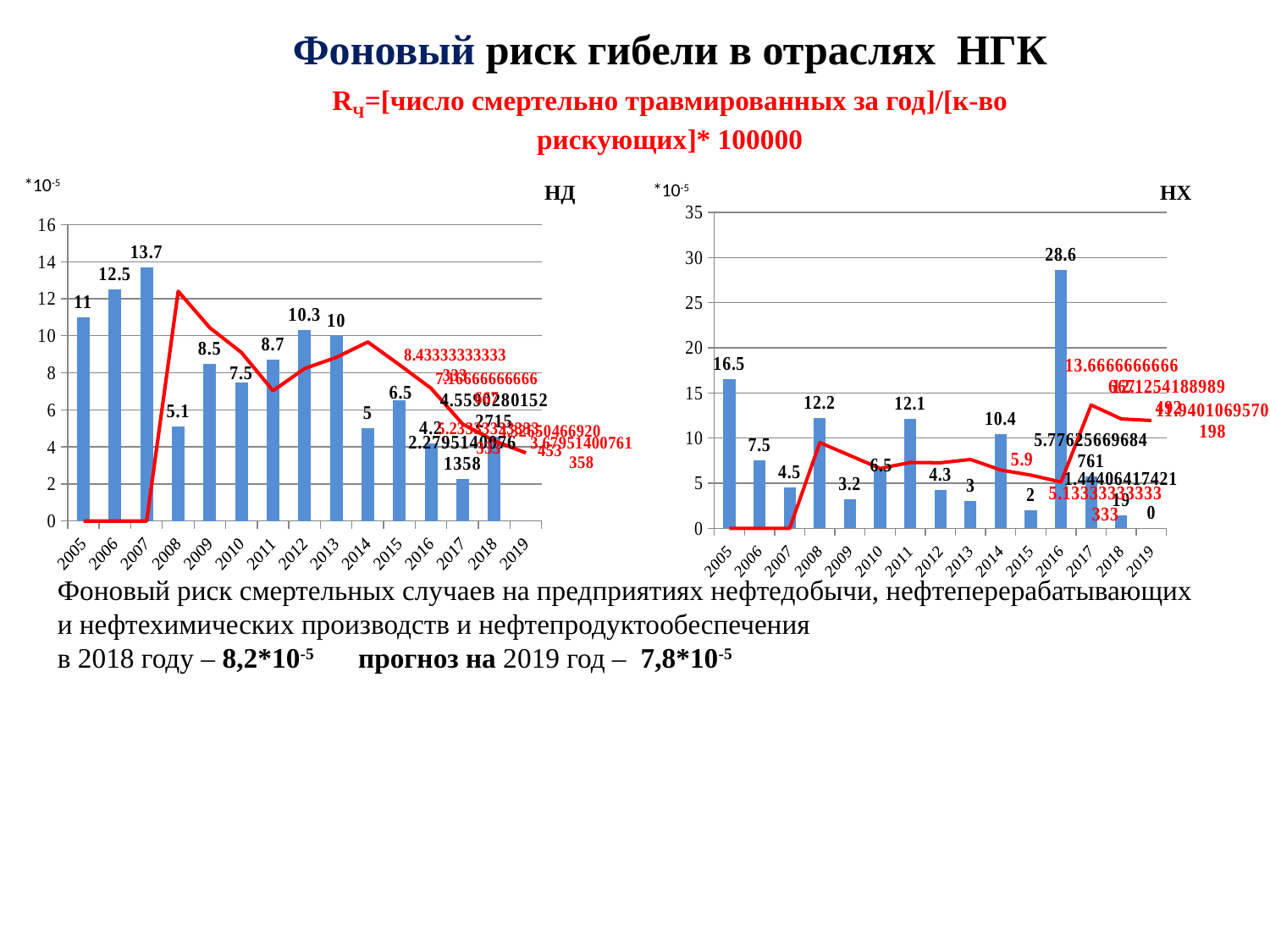
In the НХ chart (right), which is larger, the value for 2005 or the value for 2014? 2005 In the НХ chart (right), what is the value for 2005? 16.5 In the НХ chart (right), what is the difference between the values for 2016 and 2005? 12.1 How many years are shown on the x axis of the НД chart (left)? 15 In the НД chart (left), which year has the highest bar? 2007 In the НД chart (left), what is the value for 2007? 13.7 In the НХ chart (right), which year has the highest bar? 2016 In the НХ chart (right), is the value for 2009 greater or less than 5? less In the НД chart (left), what is the value for 2012? 10.3 In the НД chart (left), do the bar values rise or fall from 2005 to 2007? rise In the НД chart (left), what is the difference between the values for 2007 and 2008? 8.6 In the НХ chart (right), what is the value for 2016? 28.6